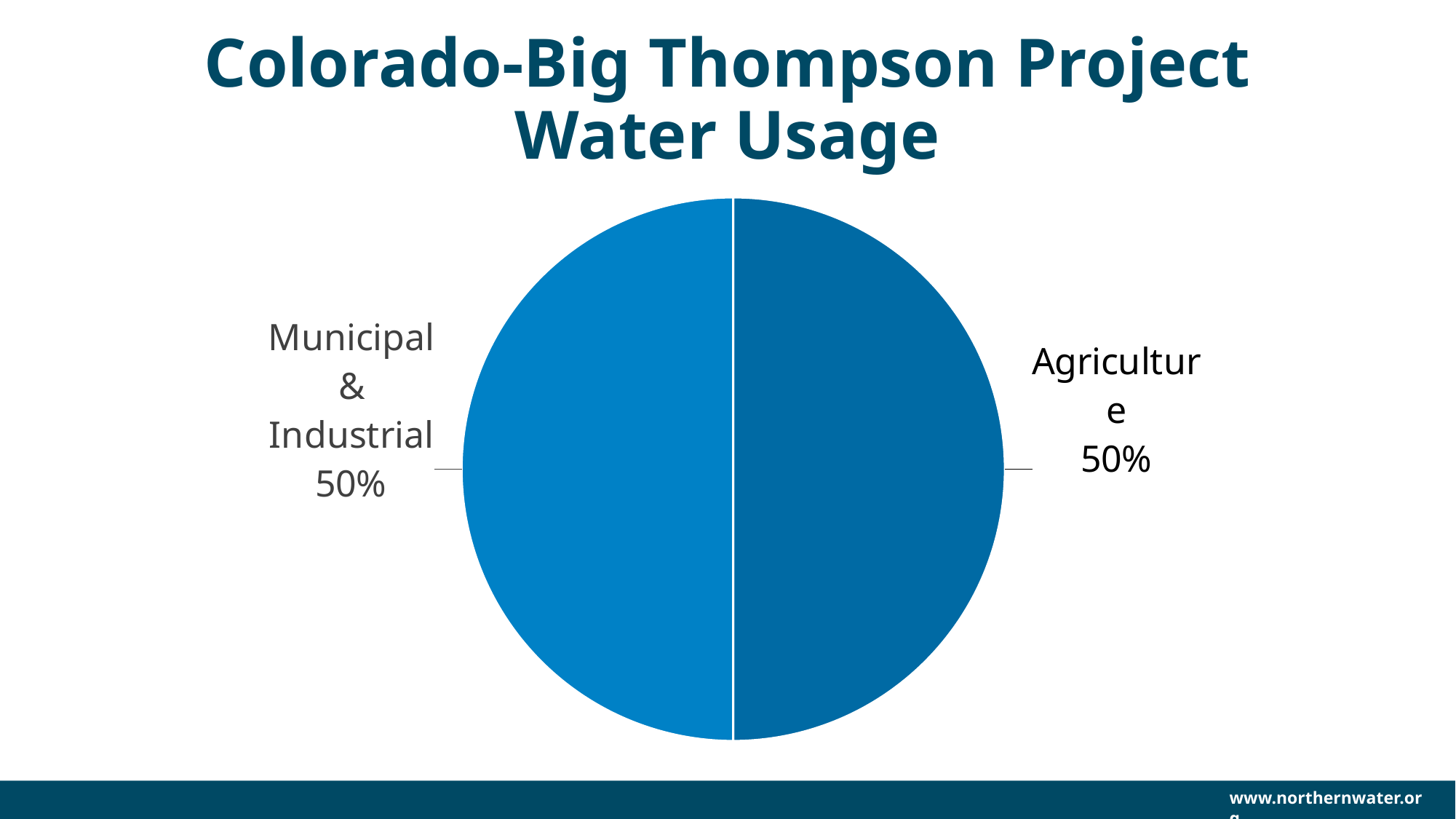
How many slices does the pie chart have? 2 What kind of chart is shown on the slide? pie chart What share of water usage is Agriculture? 50% What share of water usage is Municipal & Industrial? 50% What is the difference between the Agriculture share and the Municipal & Industrial share? 0% What is the combined share of Agriculture and Municipal & Industrial? 100% What is the title of the chart? Colorado-Big Thompson Project Water Usage Is the Agriculture share greater or less than 25%? greater Which slice is on the right side of the pie chart? Agriculture